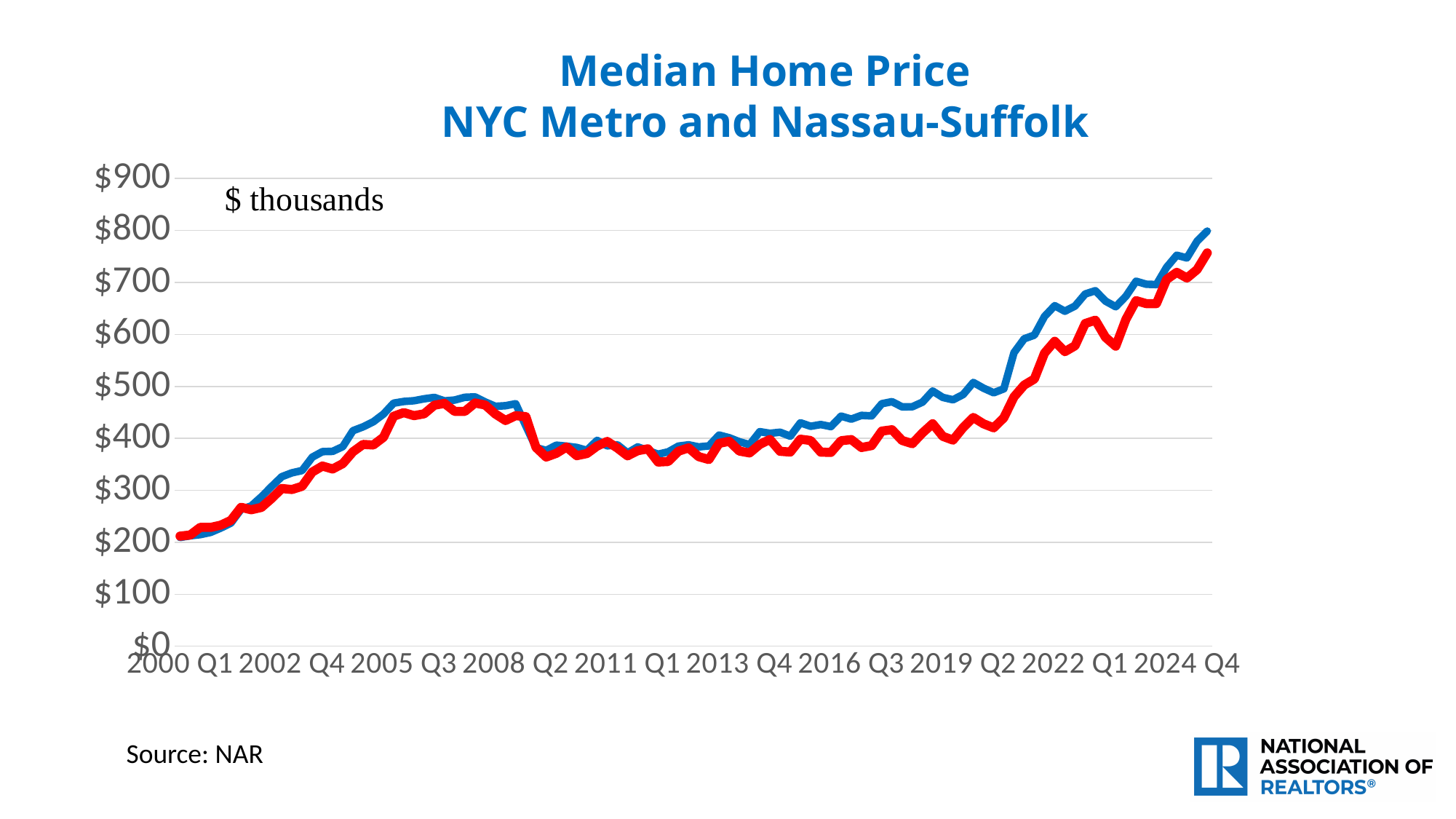
Is the value of the blue line at 2000 Q1 greater or less than $300? less Do the values of the blue line rise or fall between 2019 Q2 and 2024 Q4? Rise Do the values of the red line rise or fall between 2008 Q2 and 2011 Q1? Fall What unit is indicated for the values on the chart? $ thousands What is the title of the chart? Median Home Price NYC Metro and Nassau-Suffolk How many lines are plotted on the chart? 2 Is the value of the red line at 2011 Q1 greater or less than $500? less Is the value of the blue line at 2024 Q4 greater or less than $700? greater Which line is higher at 2024 Q4, the blue line or the red line? Blue line What kind of chart is shown on the slide? Line chart